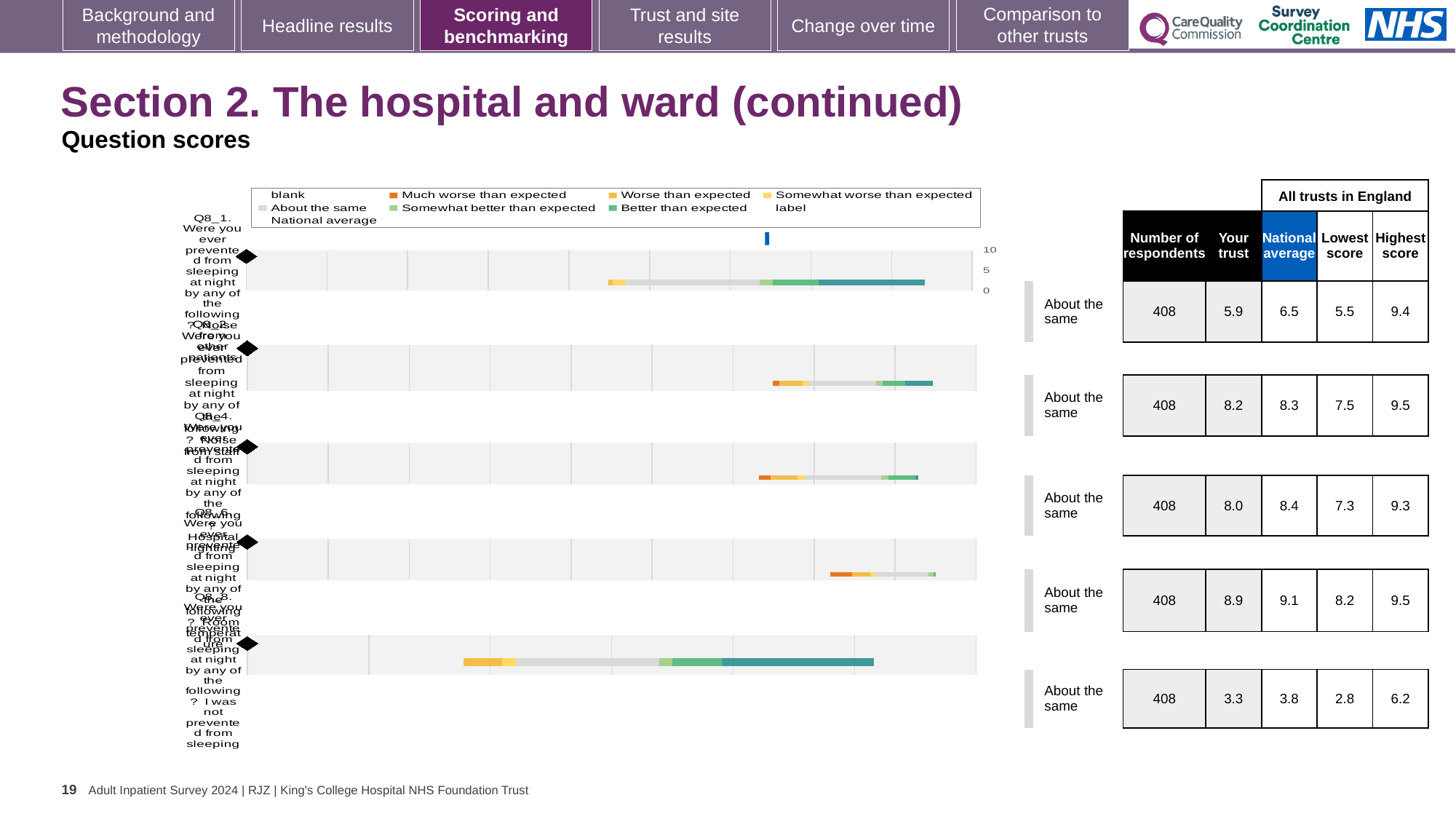
For the third question row (Q8_4), which is larger: the 'Your trust' score or the national average? National average Which question row has the lowest 'Your trust' score? Q8_8 (last row) What is the 'Your trust' score for the first question row (Q8_1)? 5.9 What is the difference between the national average and the 'Your trust' score for the first question row (Q8_1)? 0.6 Which question row has the highest 'Your trust' score? Q8_6 (fourth row) How many entries does the chart legend list? 9 What kind of chart is shown on the slide? bar chart What is the highest score across all trusts in England for the fourth question row (Q8_6)? 9.5 How many question rows (bars) does the chart show? 5 What is the national average for the first question row (Q8_1)? 6.5 What benchmark category is shown for every question row on the slide? About the same What is the 'Your trust' score for the last question row (Q8_8)? 3.3